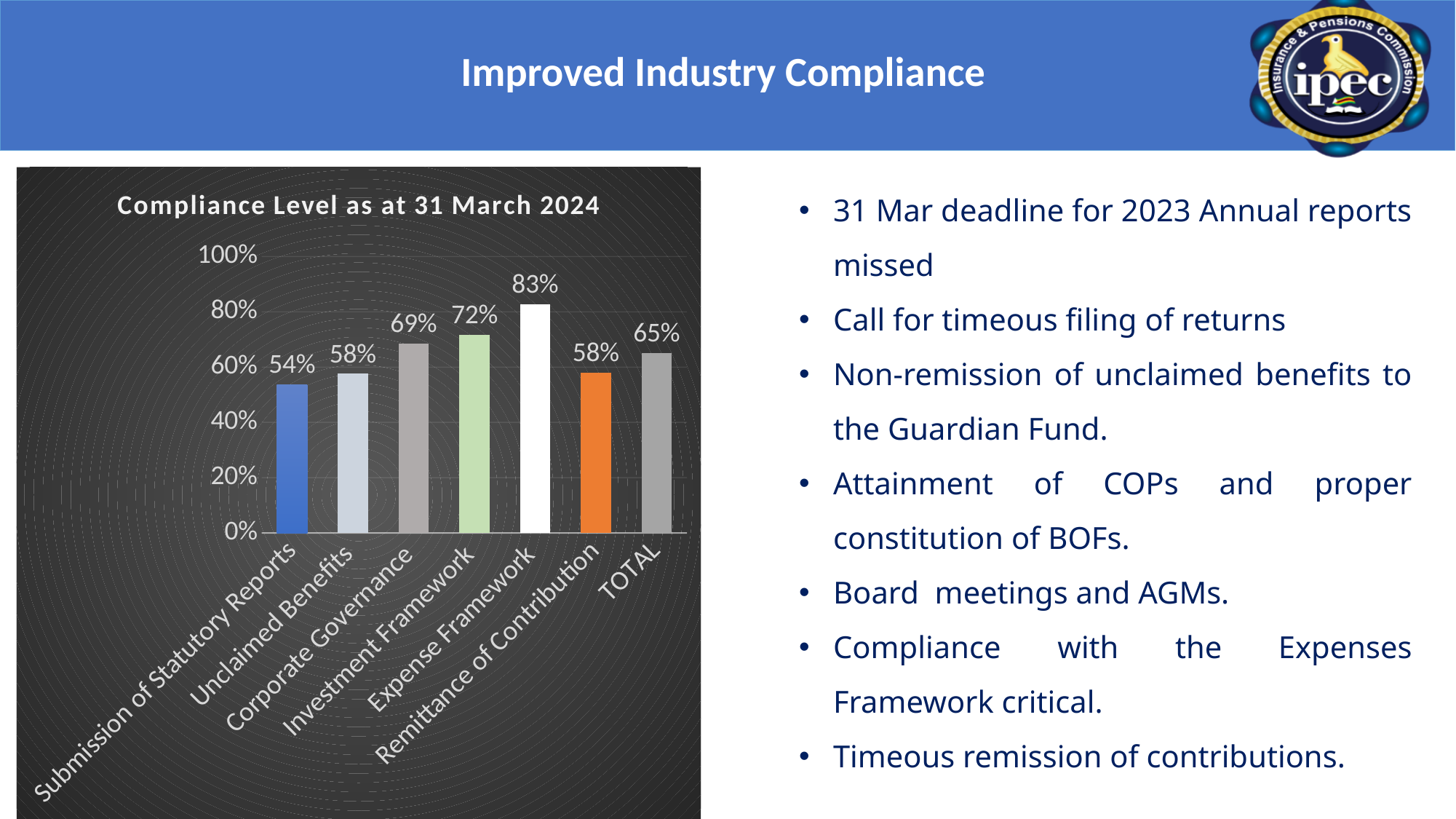
How many categories are shown on the x axis of the chart? 7 Which category has the highest compliance level? Expense Framework What is the compliance level for Expense Framework? 83% What is the title of the chart? Compliance Level as at 31 March 2024 What is the difference between the compliance levels for Expense Framework and Submission of Statutory Reports? 29% What is the compliance level for Submission of Statutory Reports? 54% What kind of chart is shown on the slide? Bar chart Which has a higher compliance level, Corporate Governance or Remittance of Contribution? Corporate Governance Which category has the lowest compliance level? Submission of Statutory Reports What is the difference between the compliance levels for Investment Framework and Corporate Governance? 3% What is the TOTAL compliance level shown in the chart? 65% What is the compliance level for Investment Framework? 72%